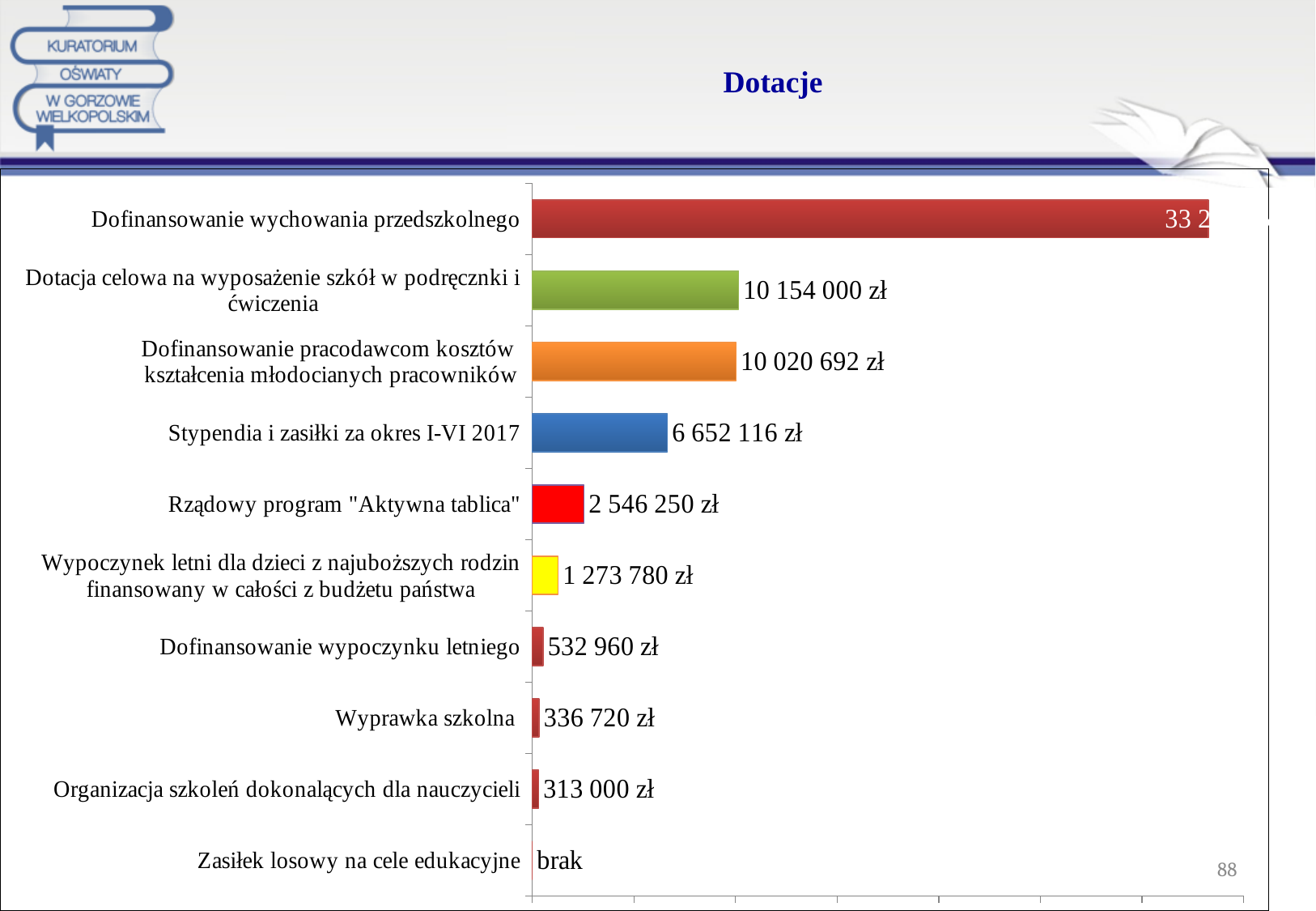
Which category with a printed value has the lowest amount? Organizacja szkoleń dokonalących dla nauczycieli What is the value for "Wyprawka szkolna"? 336 720 zł What is the value for "Rządowy program "Aktywna tablica""? 2 546 250 zł How many categories are listed on the chart? 10 What is the value for "Stypendia i zasiłki za okres I-VI 2017"? 6 652 116 zł What type of chart is shown on the slide? bar chart What is the difference between "Dofinansowanie wypoczynku letniego" and "Wyprawka szkolna"? 196 240 zł What is shown for "Zasiłek losowy na cele edukacyjne"? brak Which is larger: "Dotacja celowa na wyposażenie szkół w podręczniki i ćwiczenia" or "Dofinansowanie pracodawcom kosztów kształcenia młodocianych pracowników"? Dotacja celowa na wyposażenie szkół w podręczniki i ćwiczenia What is the value for "Dofinansowanie pracodawcom kosztów kształcenia młodocianych pracowników"? 10 020 692 zł Which category has the longest bar? Dofinansowanie wychowania przedszkolnego What is the value for "Dotacja celowa na wyposażenie szkół w podręczniki i ćwiczenia"? 10 154 000 zł